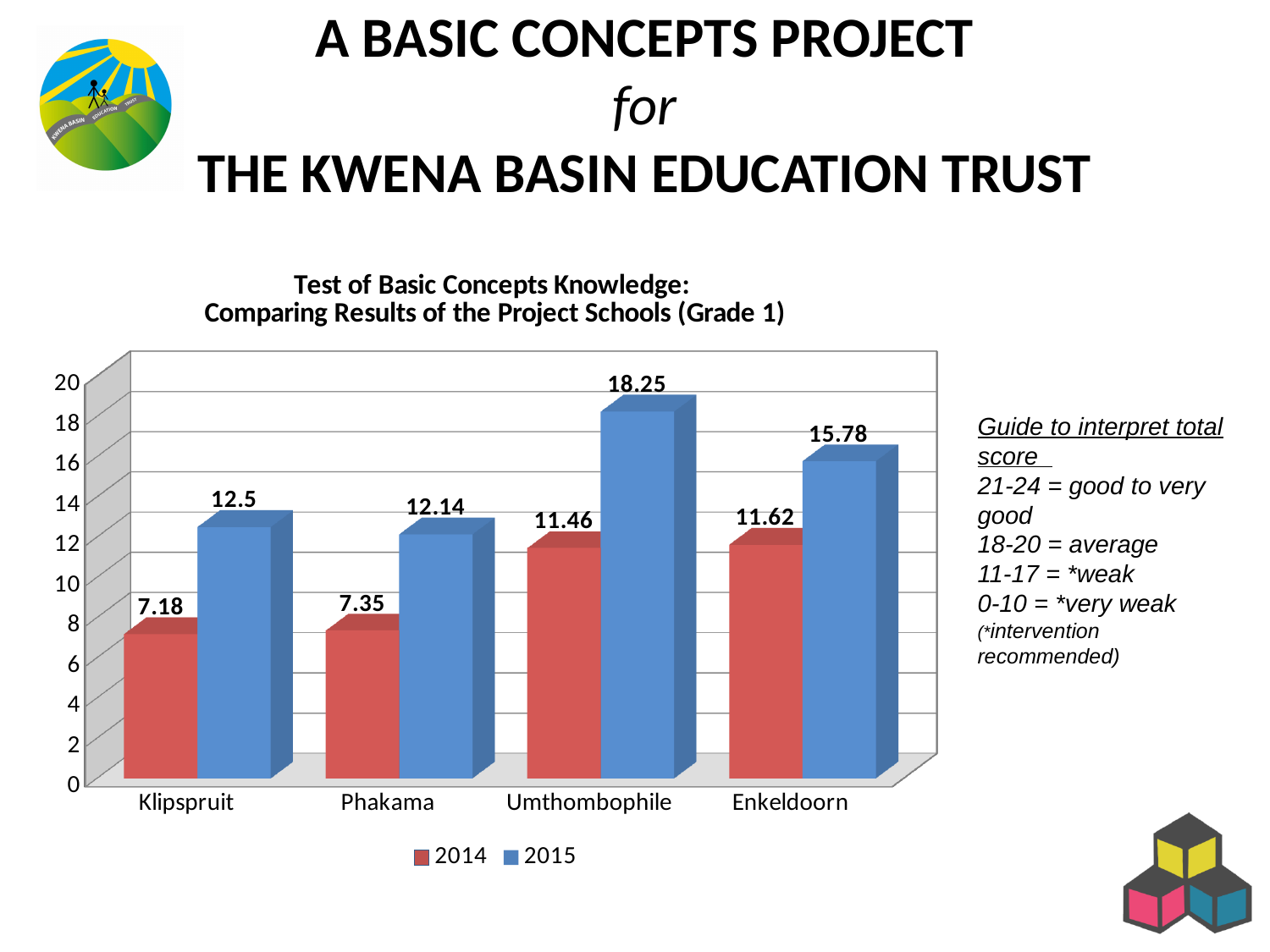
What is the difference between the 2015 and 2014 values for Umthombophile? 6.79 How many series does the legend list? 2 What is the 2015 value for Umthombophile? 18.25 What is the 2014 value for Klipspruit? 7.18 Is the 2015 value for Klipspruit greater or less than 10? greater How many schools are shown on the x axis? 4 What colour represents the 2014 series? red What is the 2015 value for Enkeldoorn? 15.78 Which school has the highest 2015 value? Umthombophile Which school has the lowest 2014 value? Klipspruit Which is larger for Phakama, the 2014 value or the 2015 value? 2015 What kind of chart is shown? bar chart